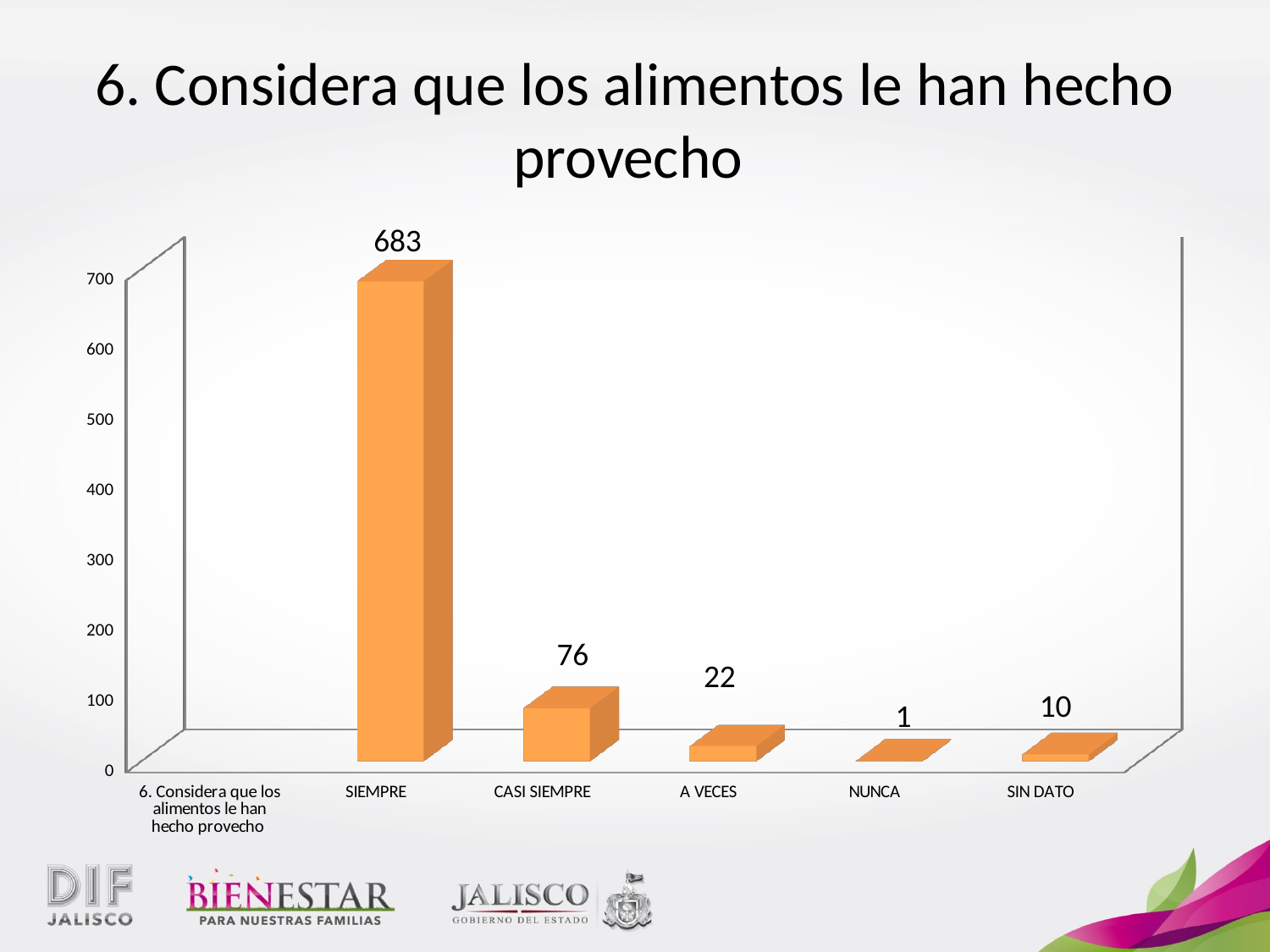
What is the value for SIEMPRE? 683 What is the title of the slide? 6. Considera que los alimentos le han hecho provecho What is the value for CASI SIEMPRE? 76 Which category has the lowest value? NUNCA What is the difference between the values for SIEMPRE and CASI SIEMPRE? 607 What is the value for SIN DATO? 10 Which category has the highest value? SIEMPRE What is the value for NUNCA? 1 Which is larger, the value for A VECES or the value for SIN DATO? A VECES Is the value for CASI SIEMPRE greater or less than 100? less What is the value for A VECES? 22 What kind of chart is shown on the slide? bar chart